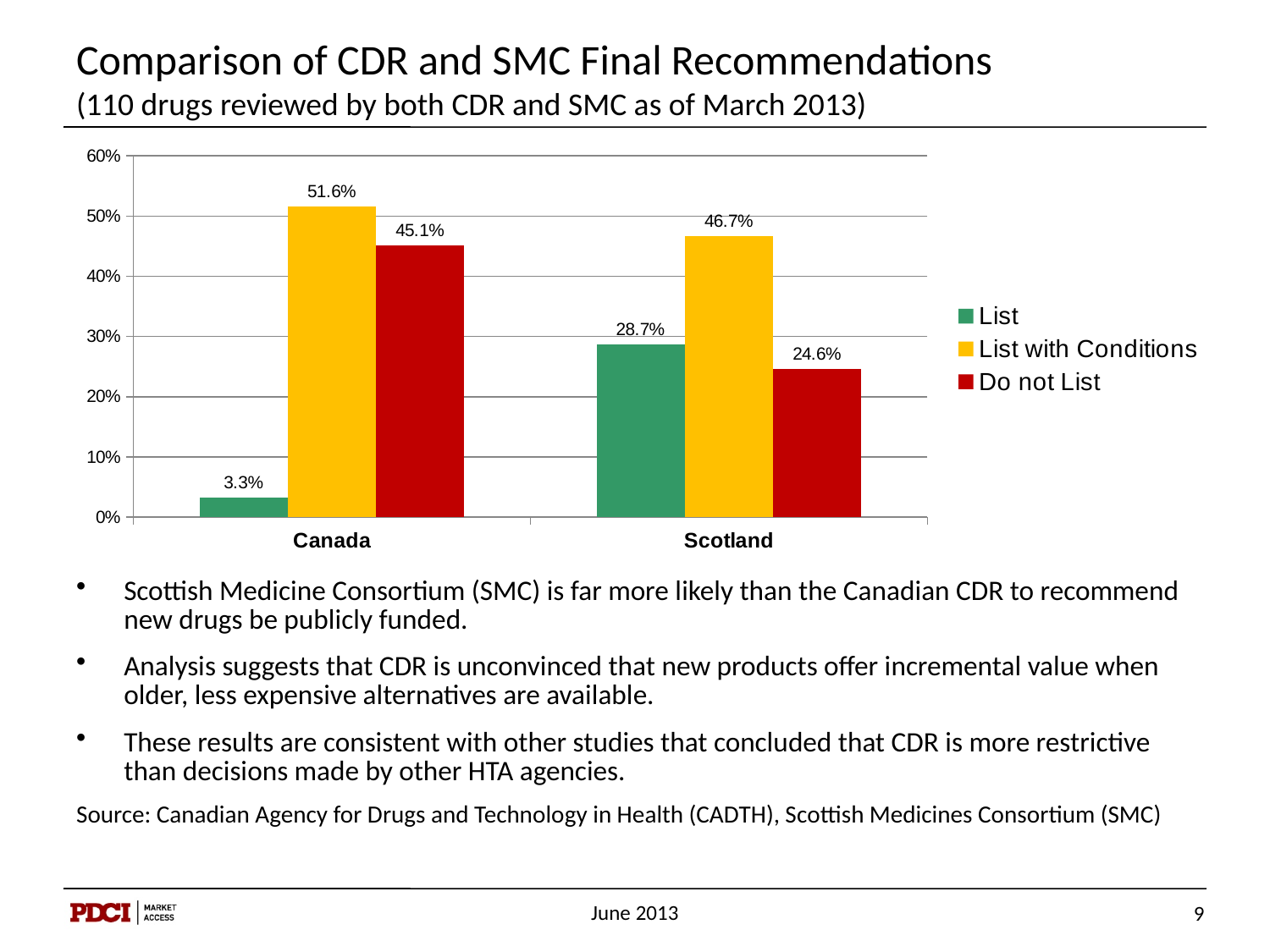
How many categories are shown on the x axis? 2 What kind of chart is shown on the slide? Bar chart What is the value for List with Conditions in Scotland? 46.7% Which series has the lowest value for Scotland? Do not List Is the value for List with Conditions in Canada greater or less than 50%? greater What is the value for List in Scotland? 28.7% Which series has the highest value for Canada? List with Conditions What is the difference between the List values for Scotland and Canada? 25.4% What is the value for List in Canada? 3.3% Which is larger, Do not List for Canada or Do not List for Scotland? Do not List for Canada How many series does the legend list? 3 What is the value for Do not List in Canada? 45.1%